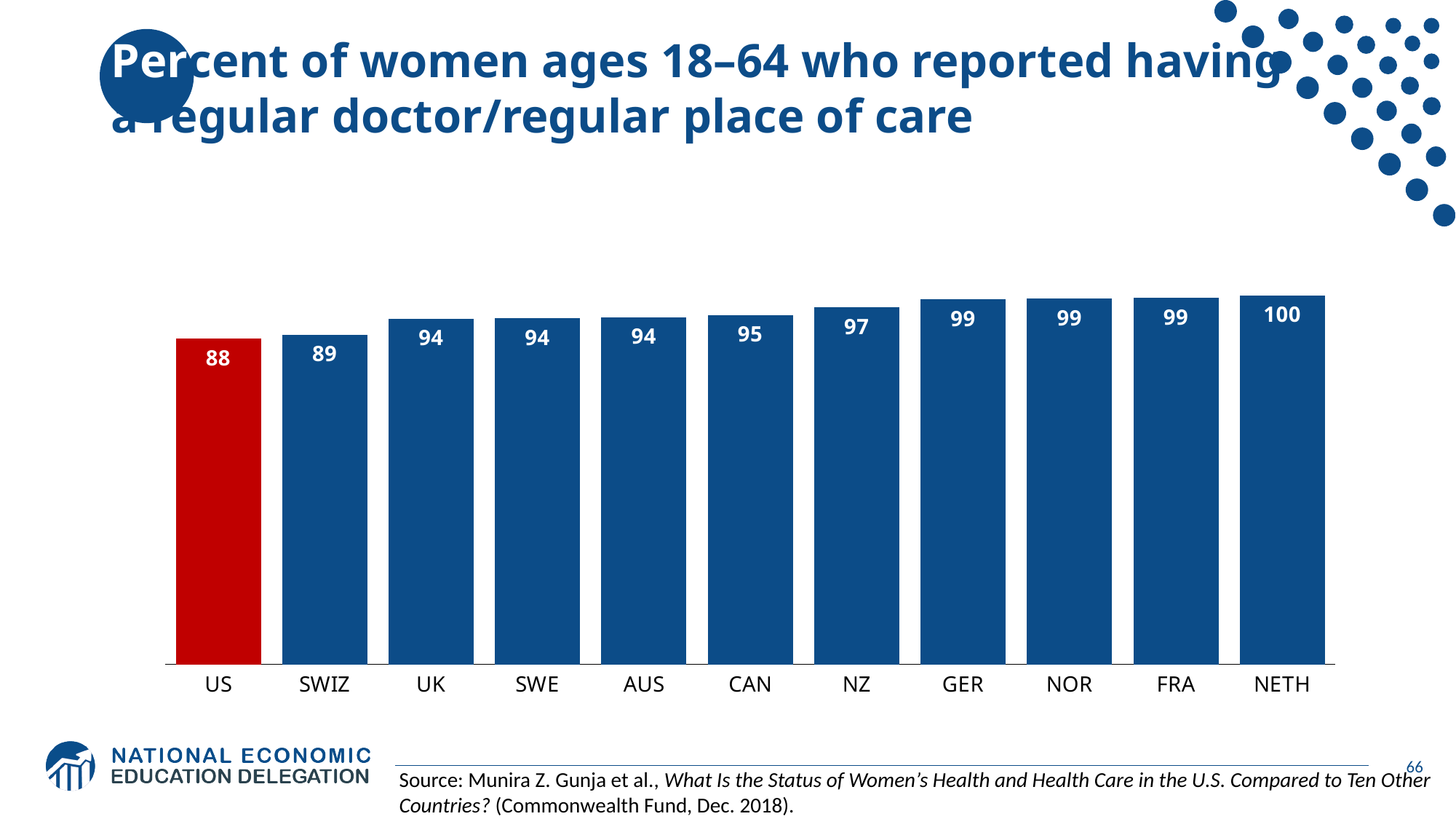
What is the value for the US? 88 Do the values rise or fall from left to right across the chart? Rise What is the difference between the values for SWIZ and UK? 5 Which country has the highest value? NETH What is the value for NZ? 97 Which bar is coloured red rather than blue? US Which country has the lowest value? US What kind of chart is shown on the slide? Bar chart How many countries are shown in the chart? 11 What is the value for CAN? 95 Which has a larger value, CAN or SWIZ? CAN What is the difference between the values for NETH and the US? 12